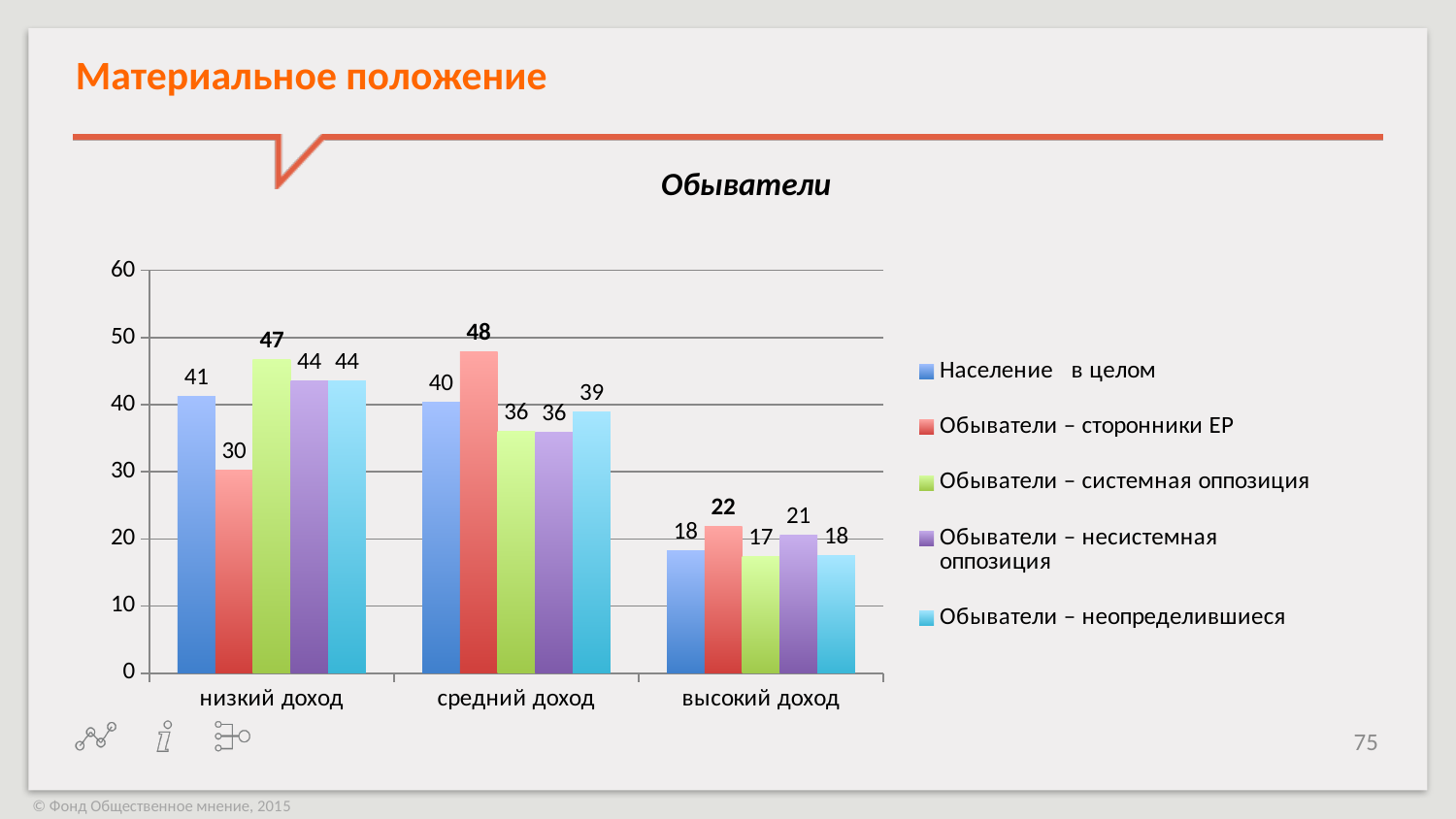
What is the value for «Обыватели – сторонники ЕР» in the «низкий доход» category? 30 How many income categories are shown on the x axis? 3 How many series does the legend list? 5 What kind of chart is shown on the slide? bar chart What is the value for «Обыватели – несистемная оппозиция» in the «высокий доход» category? 21 Which is larger in the «средний доход» category: «Обыватели – неопределившиеся» or «Обыватели – системная оппозиция»? Обыватели – неопределившиеся Which series has the lowest value in the «высокий доход» category? Обыватели – системная оппозиция What is the difference between «Обыватели – системная оппозиция» and «Обыватели – сторонники ЕР» in the «низкий доход» category? 17 Which series has the highest value in the «средний доход» category? Обыватели – сторонники ЕР Do the values for «Население в целом» rise or fall from «низкий доход» to «высокий доход»? fall Is the value for «Обыватели – сторонники ЕР» in the «средний доход» category greater or less than 40? greater What is the value for «Население в целом» in the «средний доход» category? 40